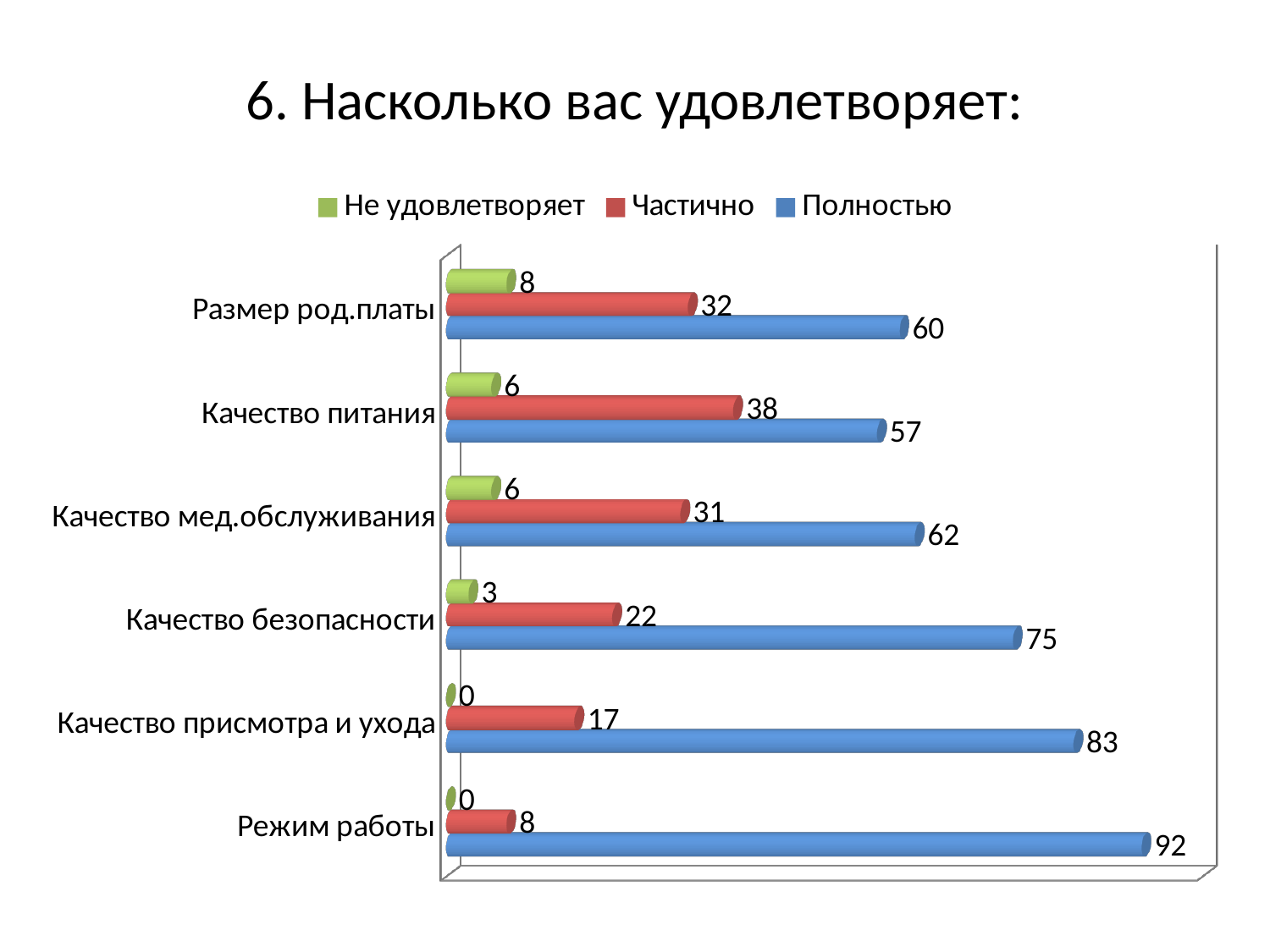
What is the value for "Полностью" for "Режим работы"? 92 What kind of chart is shown on the slide? Bar chart Which is larger: the "Частично" value for "Размер род.платы" or for "Качество мед.обслуживания"? Размер род.платы How many categories are shown on the chart? 6 Which category has the highest value for "Полностью"? Режим работы How many series does the legend list? 3 What is the value for "Частично" for "Качество питания"? 38 Which category has the lowest value for "Полностью"? Качество питания What is the total of the three values for "Качество безопасности"? 100 What is the difference between the "Полностью" values for "Качество присмотра и ухода" and "Качество безопасности"? 8 Which series is shown in blue in the legend? Полностью What is the value for "Не удовлетворяет" for "Размер род.платы"? 8